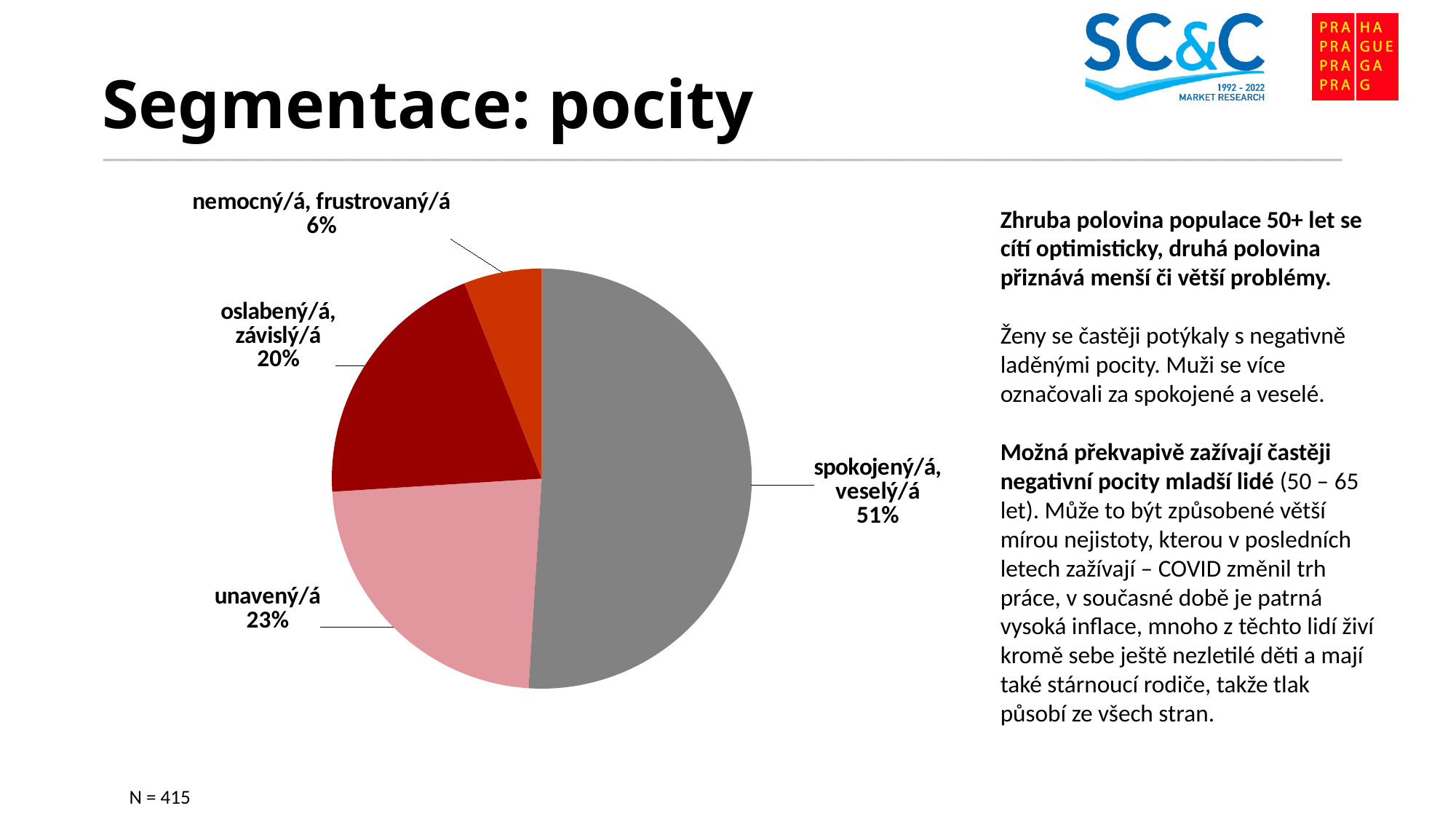
What kind of chart is shown on the slide? Pie chart How many categories are shown in the pie chart? 4 What share of the pie does the "spokojený/á, veselý/á" slice represent? 51% What sample size (N) is stated on the slide? N = 415 Which category has the smallest slice of the pie? nemocný/á, frustrovaný/á Which is larger, the slice for "unavený/á" or the slice for "oslabený/á, závislý/á"? unavený/á What is the value shown for "unavený/á"? 23% What is the combined share of "oslabený/á, závislý/á" and "nemocný/á, frustrovaný/á"? 26% What is the value shown for "oslabený/á, závislý/á"? 20% What is the value shown for "nemocný/á, frustrovaný/á"? 6% What is the difference in percentage points between "spokojený/á, veselý/á" and "unavený/á"? 28 percentage points Which category has the largest slice of the pie? spokojený/á, veselý/á